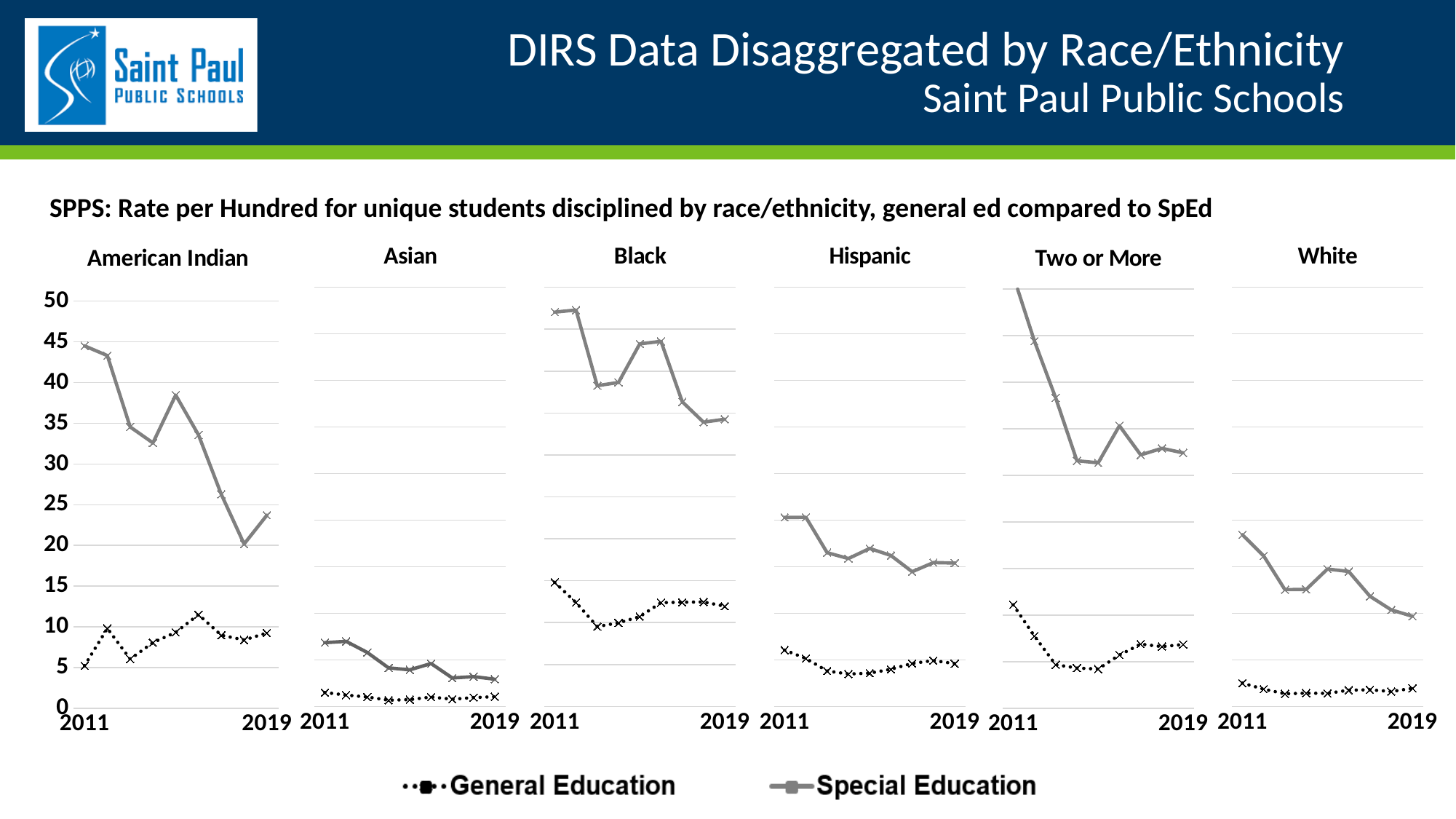
How many race/ethnicity panels are shown on the slide? 6 In the Two or More panel, does the Special Education line rise or fall from 2011 to 2019? fall How many series does the legend list? 2 In the American Indian panel, is the Special Education value for 2011 greater or less than 40? greater Which panel has the higher Special Education value in 2011, Black or American Indian? Black In the Hispanic panel, is the Special Education value for 2011 greater or less than 20? greater In the White panel, is the Special Education value for 2019 greater or less than 15? less What kind of chart is used in each of the six race/ethnicity panels? line chart What are the two series named in the legend? General Education and Special Education In the Asian panel, which series is higher in 2011, General Education or Special Education? Special Education